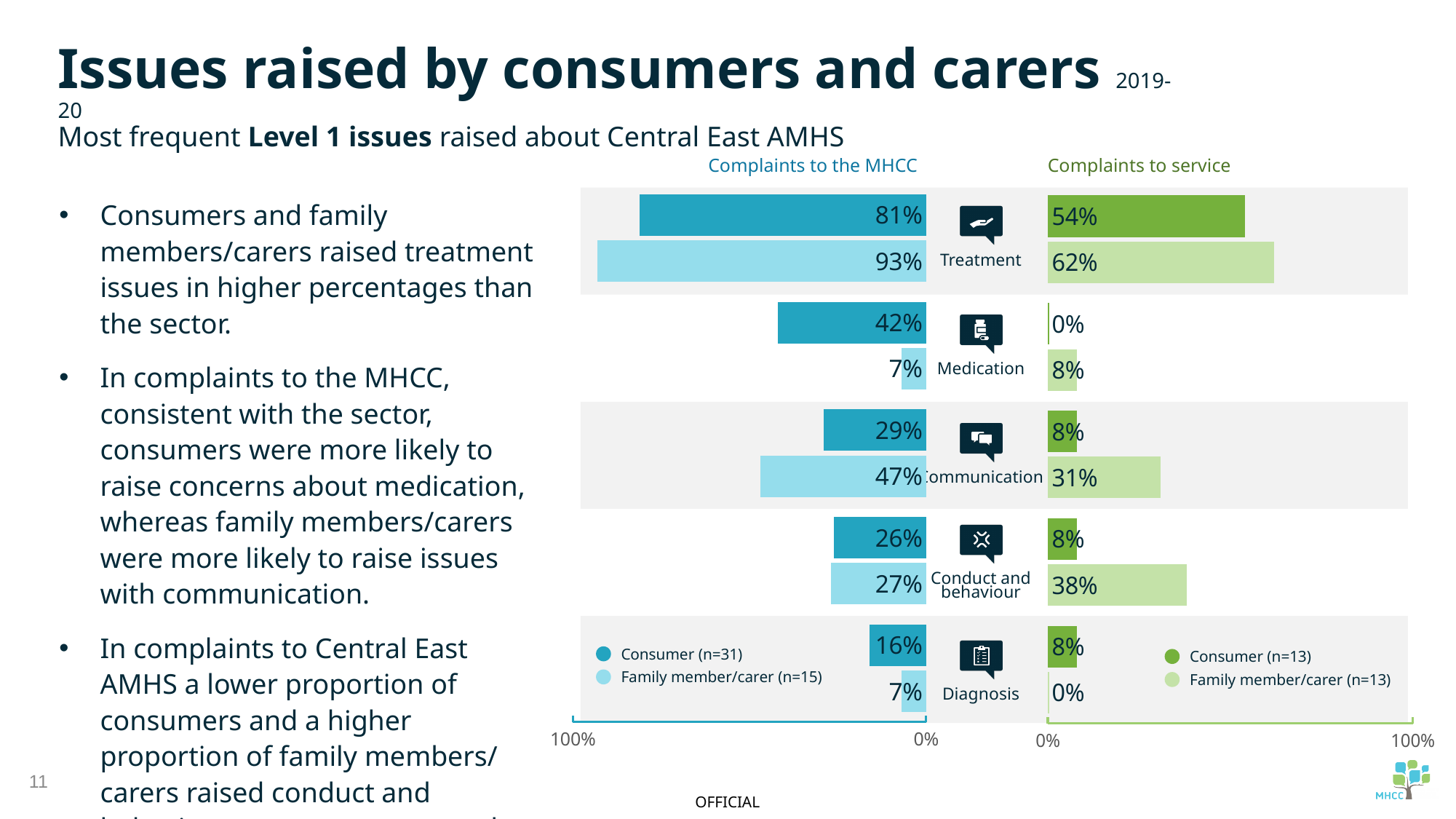
In the 'Complaints to the MHCC' chart, what is the difference between the family member/carer and consumer percentages for treatment? 12% How many issue categories are shown in the 'Complaints to the MHCC' chart? 5 What type of chart is the 'Complaints to service' chart? Bar chart In the 'Complaints to service' chart, what percentage of consumers raised medication issues? 0% In the 'Complaints to the MHCC' chart, which issue has the lowest percentage for consumers? Diagnosis In the 'Complaints to the MHCC' chart, which is larger for medication: the consumer percentage or the family member/carer percentage? Consumer How many series does the legend of the 'Complaints to service' chart list? 2 In the 'Complaints to service' chart, what percentage of family members/carers raised conduct and behaviour issues? 38% In the 'Complaints to service' chart, what is the difference between the family member/carer and consumer percentages for communication? 23% In the 'Complaints to the MHCC' chart, which issue has the highest percentage for family members/carers? Treatment In the 'Complaints to the MHCC' chart, what percentage of family members/carers raised communication issues? 47% In the 'Complaints to the MHCC' chart, what percentage of consumers raised treatment issues? 81%